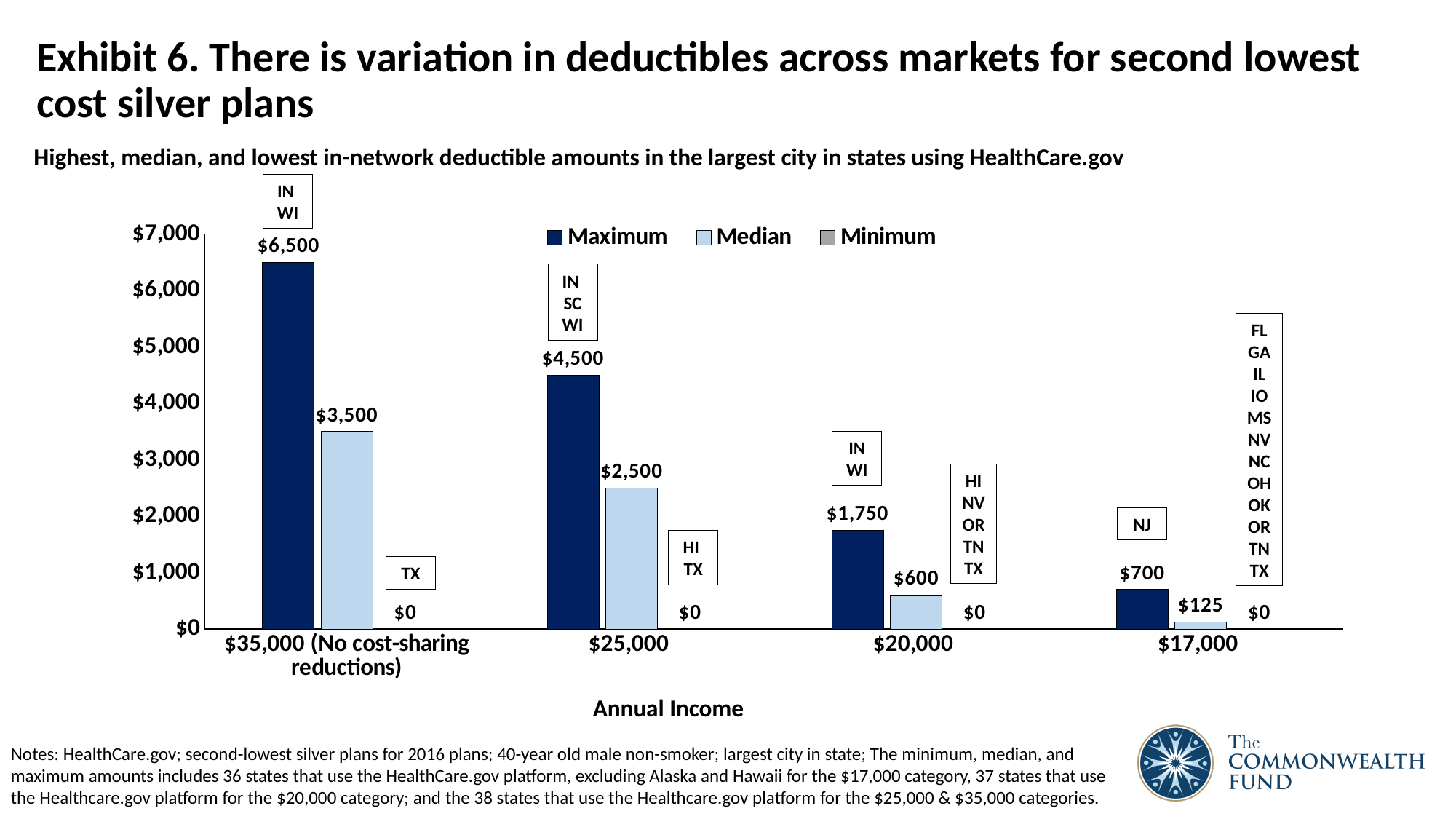
How many income categories are shown on the x axis? 4 What is the Maximum deductible for the $35,000 (No cost-sharing reductions) income category? $6,500 What is the Maximum deductible for the $20,000 income category? $1,750 Which income category has the highest Maximum deductible? $35,000 (No cost-sharing reductions) Which is larger: the Median deductible for $35,000 (No cost-sharing reductions) or the Maximum deductible for $25,000? Maximum deductible for $25,000 What is the Median deductible for the $25,000 income category? $2,500 What kind of chart is shown on the slide? Bar chart Do the Maximum deductible values rise or fall moving from the $35,000 category to the $17,000 category along the x axis? Fall What is the difference between the Maximum and Median deductibles for the $25,000 income category? $2,000 How many series does the legend list? 3 What is the Median deductible for the $17,000 income category? $125 Which income category has the lowest Median deductible? $17,000